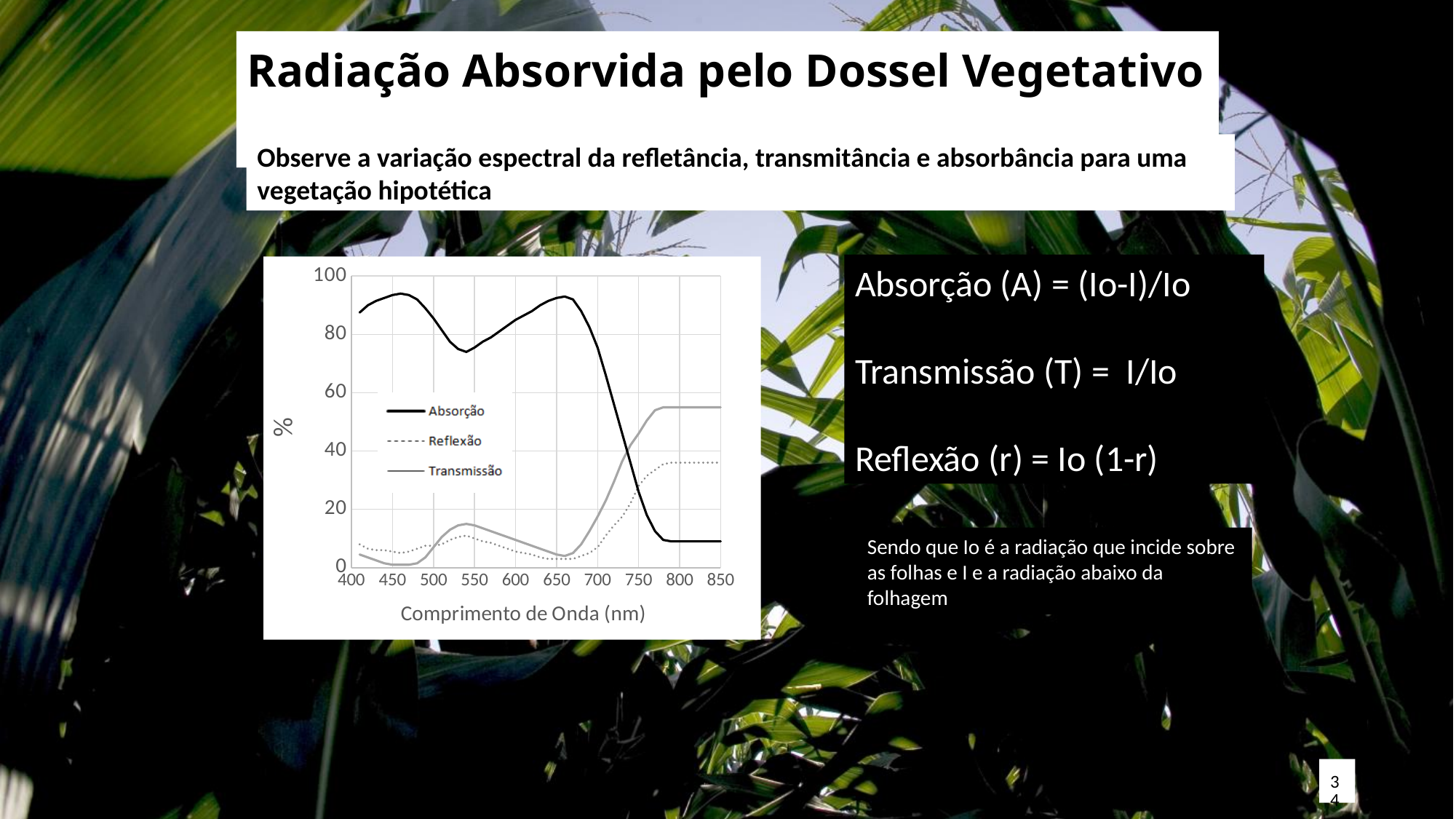
At 450 nm, which is larger: Absorção or Transmissão? Absorção Is the value of Absorção at 450 nm greater or less than 80? greater Which series has the lowest value at 850 nm? Absorção Is the value of Transmissão at 850 nm greater or less than 40? greater What is the title of the x axis of the chart? Comprimento de Onda (nm) Which series are listed in the chart legend? Absorção, Reflexão, Transmissão Does the Absorção series rise or fall between 700 nm and 800 nm? Fall Is the value of Absorção at 800 nm greater or less than 20? less How many series does the chart legend list? 3 What kind of chart is shown on the slide? Line chart At 850 nm, which is larger: Transmissão or Reflexão? Transmissão